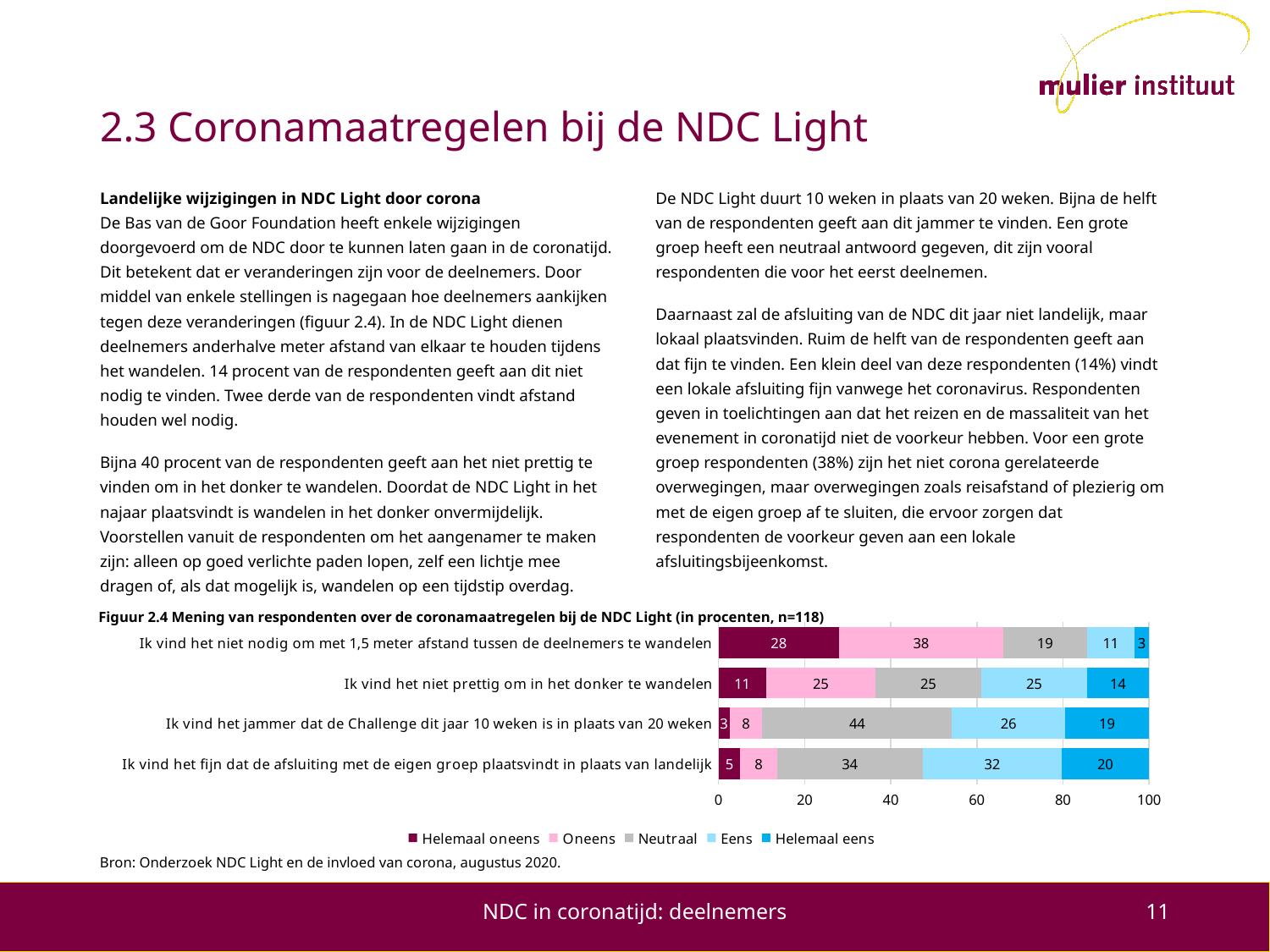
What is the 'Helemaal oneens' value for 'Ik vind het niet nodig om met 1,5 meter afstand tussen de deelnemers te wandelen'? 28 What is the 'Neutraal' value for 'Ik vind het jammer dat de Challenge dit jaar 10 weken is in plaats van 20 weken'? 44 Which statement has the highest 'Helemaal oneens' value? Ik vind het niet nodig om met 1,5 meter afstand tussen de deelnemers te wandelen How many statements (categories) are plotted in Figuur 2.4? 4 What is the combined total of 'Helemaal oneens' and 'Oneens' for 'Ik vind het niet prettig om in het donker te wandelen'? 36 What is the difference between the 'Oneens' values for 'Ik vind het niet nodig om met 1,5 meter afstand tussen de deelnemers te wandelen' and 'Ik vind het niet prettig om in het donker te wandelen'? 13 Which is larger: the 'Eens' value for 'Ik vind het fijn dat de afsluiting met de eigen groep plaatsvindt in plaats van landelijk' or the 'Eens' value for 'Ik vind het jammer dat de Challenge dit jaar 10 weken is in plaats van 20 weken'? Ik vind het fijn dat de afsluiting met de eigen groep plaatsvindt in plaats van landelijk Which statement has the lowest 'Helemaal eens' value? Ik vind het niet nodig om met 1,5 meter afstand tussen de deelnemers te wandelen Which legend entry is shown in dark purple in Figuur 2.4? Helemaal oneens How many series does the legend of Figuur 2.4 list? 5 What is the 'Helemaal eens' value for 'Ik vind het fijn dat de afsluiting met de eigen groep plaatsvindt in plaats van landelijk'? 20 What kind of chart is shown in Figuur 2.4? Stacked bar chart